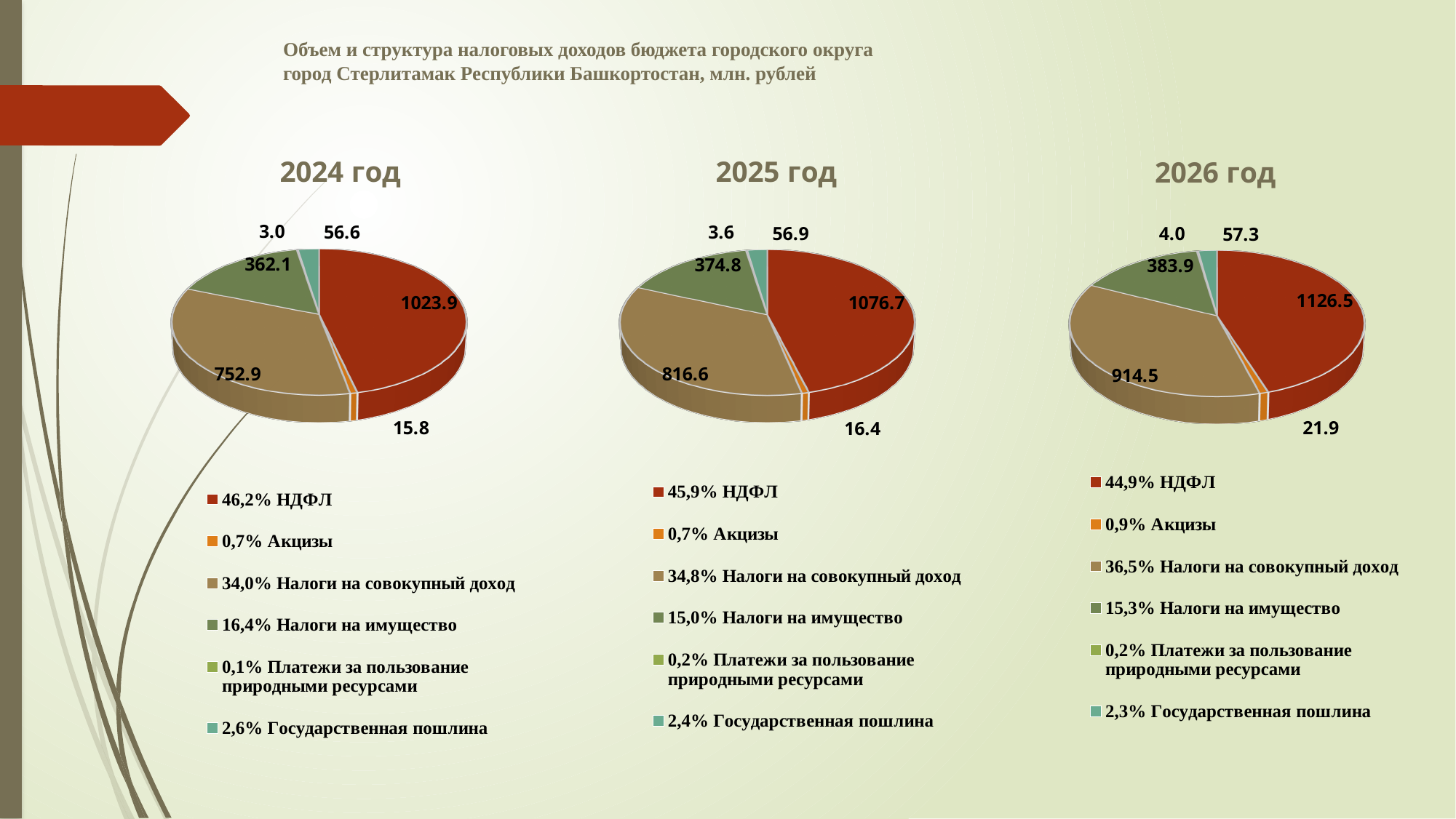
In the 2025 год chart, what is the value for Налоги на совокупный доход? 816.6 How many slices does the 2025 год pie chart have? 6 In the 2024 год chart, what share of the pie does Налоги на имущество represent? 16,4% In the 2026 год chart, what is the value for Акцизы? 21.9 In the 2026 год chart, which is larger: Налоги на имущество or Государственная пошлина? Налоги на имущество In the 2026 год chart, what share of the pie does НДФЛ represent? 44,9% What kind of chart is used for 2024 год? Pie chart In the 2024 год chart, what is the value for НДФЛ? 1023.9 In the 2024 год chart, which category has the smallest slice? Платежи за пользование природными ресурсами In the 2026 год chart, which category has the largest slice? НДФЛ How many charts are shown on the slide? 3 In the 2025 год chart, what is the difference between the values for НДФЛ and Налоги на совокупный доход? 260.1